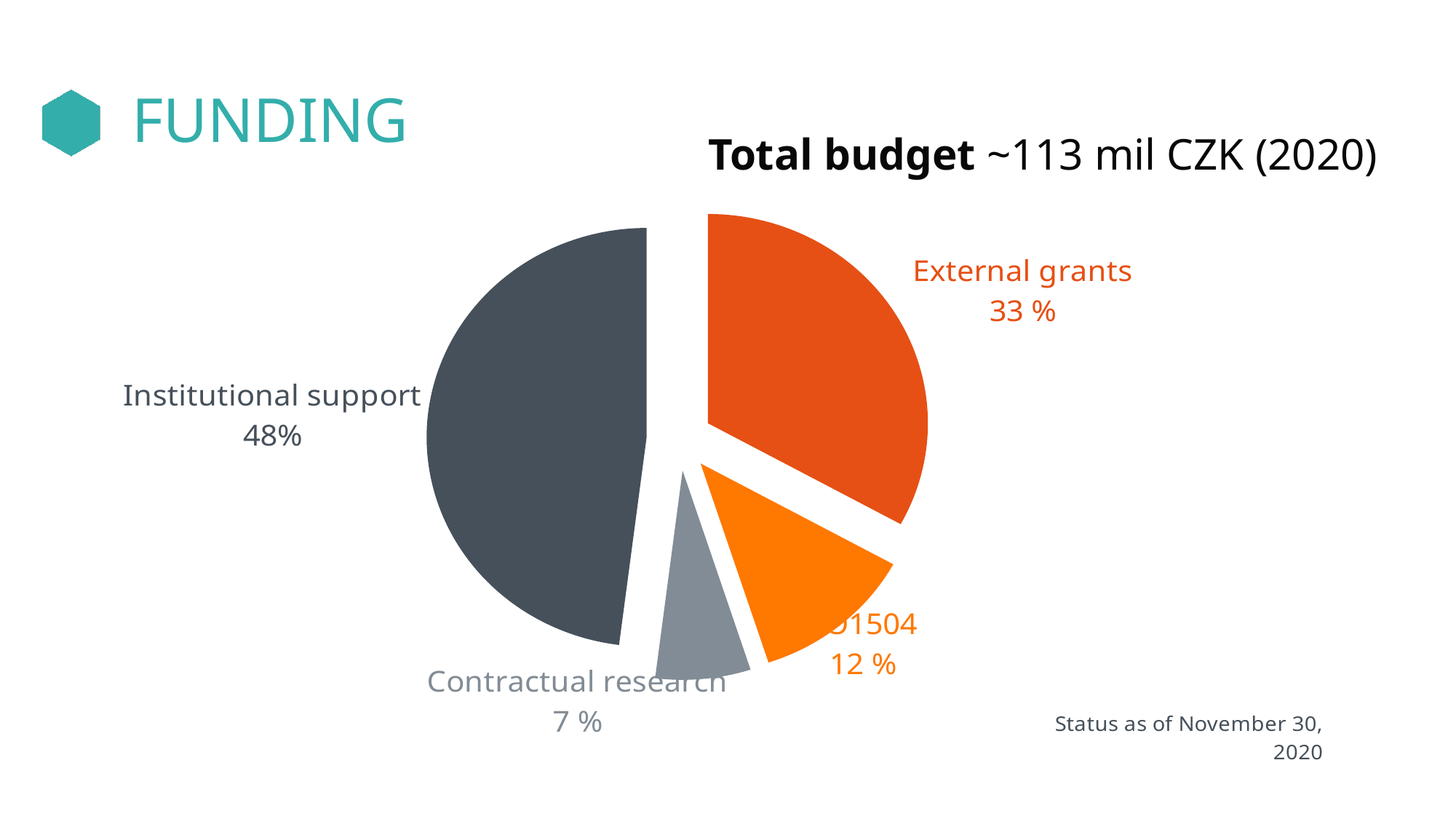
What is the difference in percentage points between Institutional support and External grants? 15 What total budget is stated on the slide? ~113 mil CZK (2020) What share of the funding pie chart is External grants? 33 % Which category has the largest slice of the funding pie chart? Institutional support What share of the funding pie chart is Institutional support? 48% How many slices does the funding pie chart have? 4 Which is larger in the funding pie chart, External grants or Contractual research? External grants What share of the funding pie chart is Contractual research? 7 % What is the difference in percentage points between External grants and Contractual research? 26 Which category has the smallest slice of the funding pie chart? Contractual research What kind of chart is shown on the slide? Pie chart What colour is the Institutional support slice of the pie chart? Dark grey